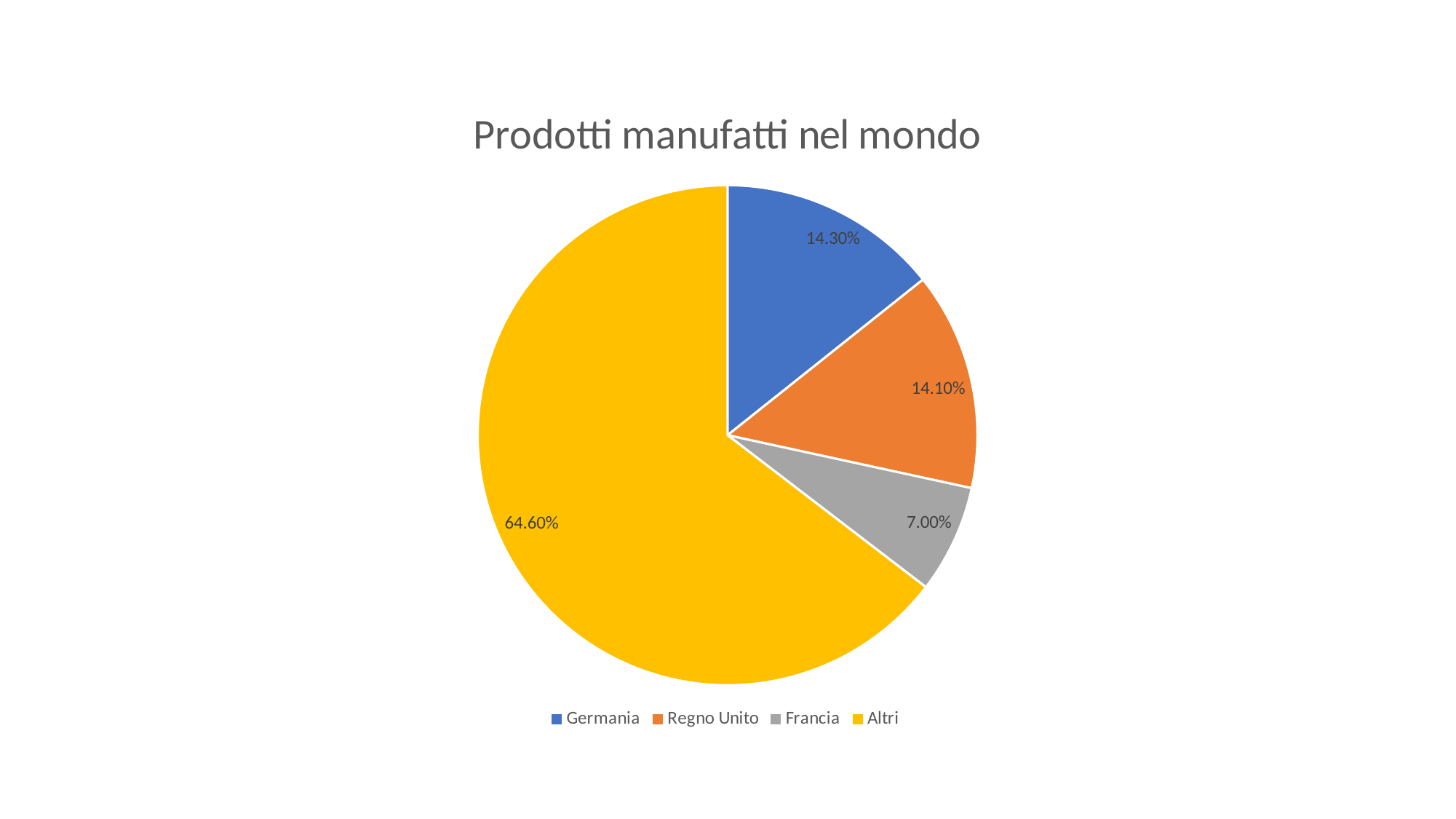
Which is larger, the value for Germania or the value for Francia? Germania What kind of chart is shown on the slide? Pie chart What is the value for Regno Unito? 14.10% Which category has the largest slice? Altri Which category has the smallest slice? Francia What is the value for Germania? 14.30% What is the difference between the values for Altri and Regno Unito? 50.50% What is the value for Altri? 64.60% What is the title of the chart? Prodotti manufatti nel mondo What is the value for Francia? 7.00% How many categories does the pie chart show? 4 What is the difference between the values for Germania and Francia? 7.30%